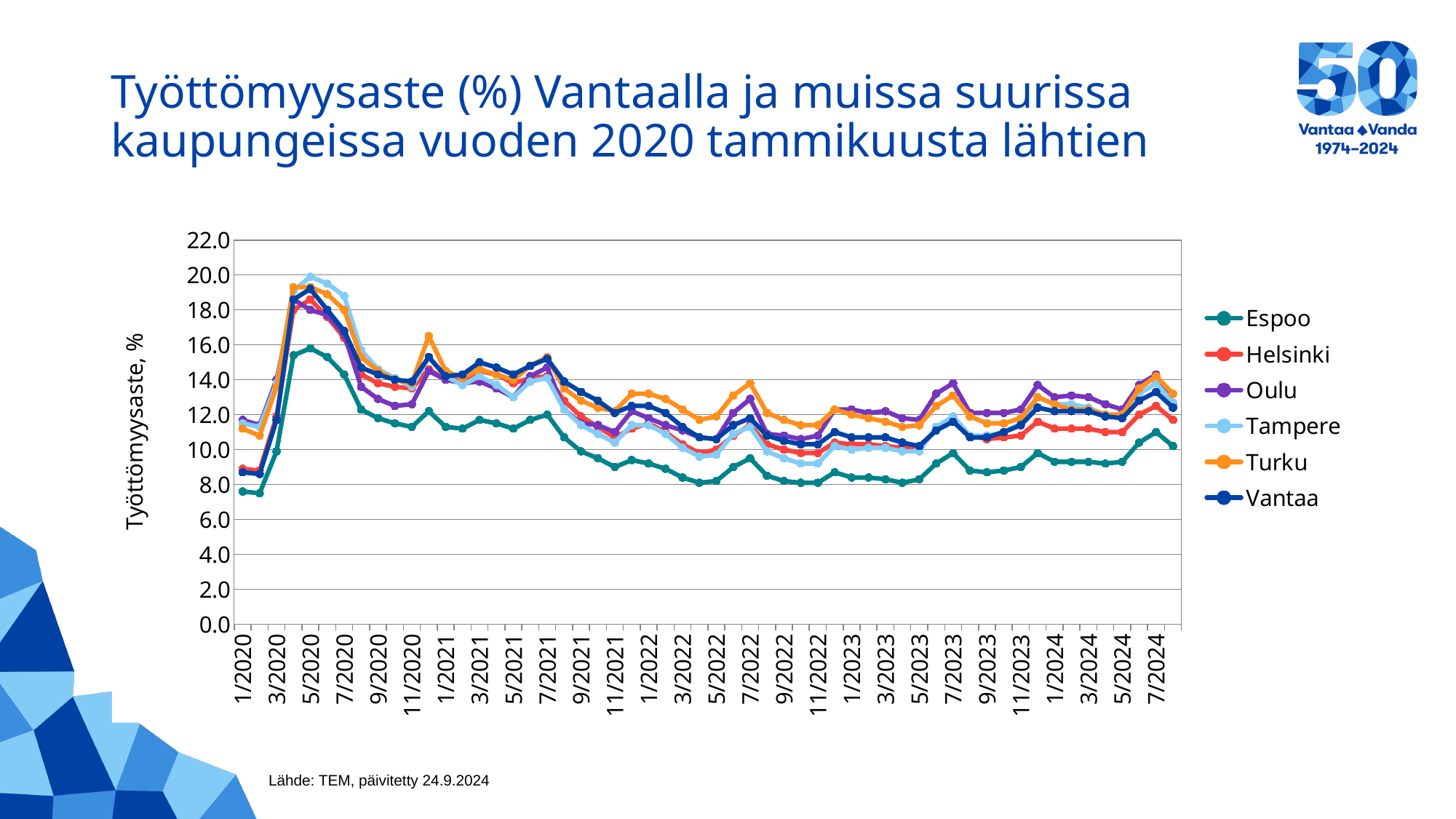
Is the value for Tampere at 5/2020 greater or less than 18.0? greater What kind of chart is shown on the slide? Line chart Is the value for Oulu at 7/2023 greater or less than 12.0? greater Is the value for Helsinki at 1/2020 greater or less than 10.0? less Do the values for Vantaa rise or fall between 5/2020 and 5/2022? fall Do the values for Espoo rise or fall between 1/2020 and 5/2020? rise How many series does the legend list? 6 Which series reaches the highest value at the 5/2020 peak? Tampere What is the label of the vertical axis? Työttömyysaste, % Which series is the lowest across the whole period, for example at 7/2022? Espoo